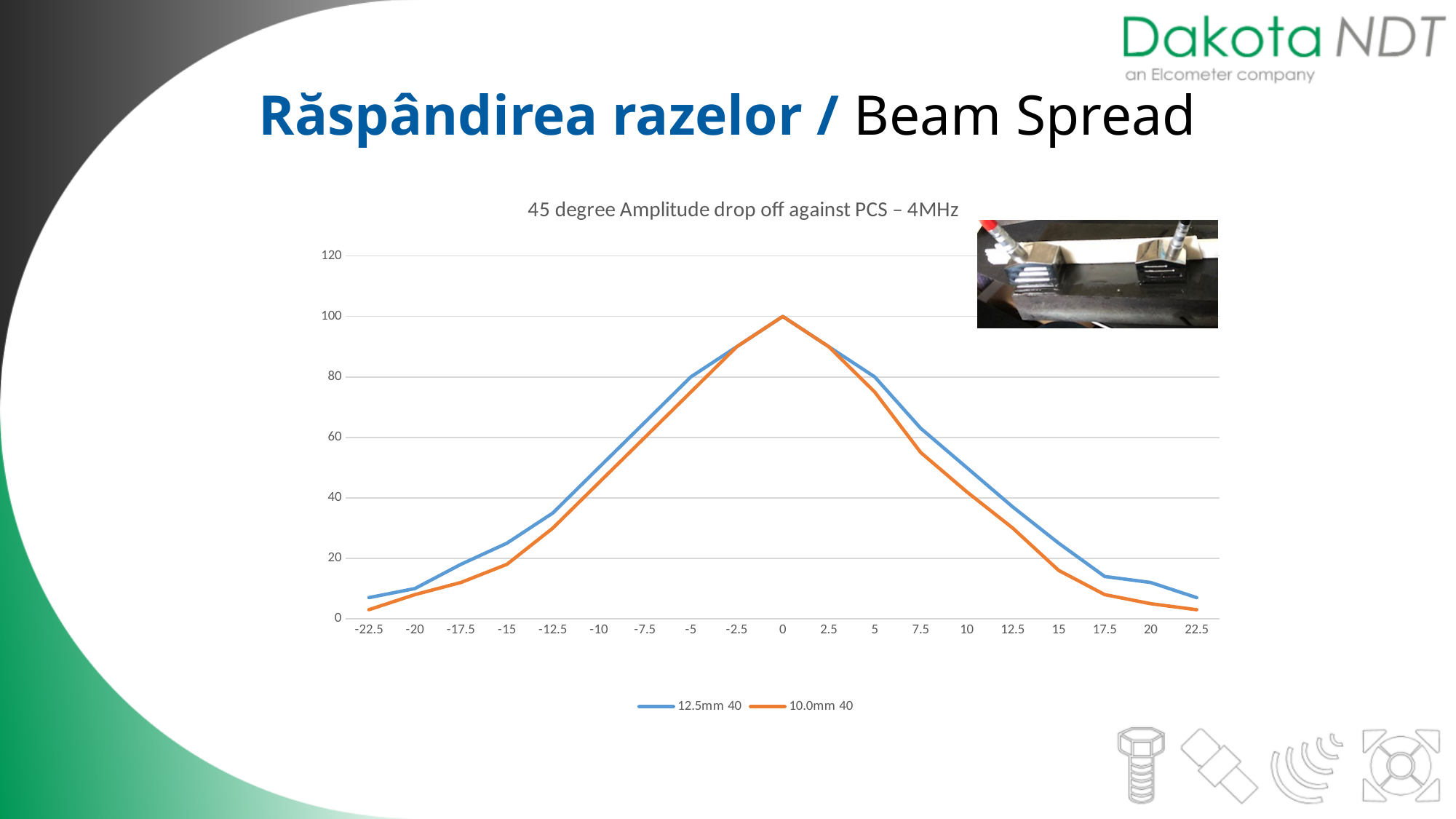
What is the value of the 12.5mm 40 series at 0? 100 At which x-axis position does the 10.0mm 40 series reach its highest value? 0 What kind of chart is shown on the slide? line chart Is the value of the 10.0mm 40 series at 15 greater or less than 20? less How many points are labelled along the x axis? 19 How many series does the legend list? 2 At 7.5, which series has the larger value, 12.5mm 40 or 10.0mm 40? 12.5mm 40 Is the value of the 10.0mm 40 series at 7.5 greater or less than 60? less Do the values of the 12.5mm 40 series rise or fall from 0 to 22.5 along the x axis? fall What is the title of the chart? 45 degree Amplitude drop off against PCS – 4MHz Which series is drawn in orange? 10.0mm 40 Is the value of the 12.5mm 40 series at 10 greater or less than 40? greater